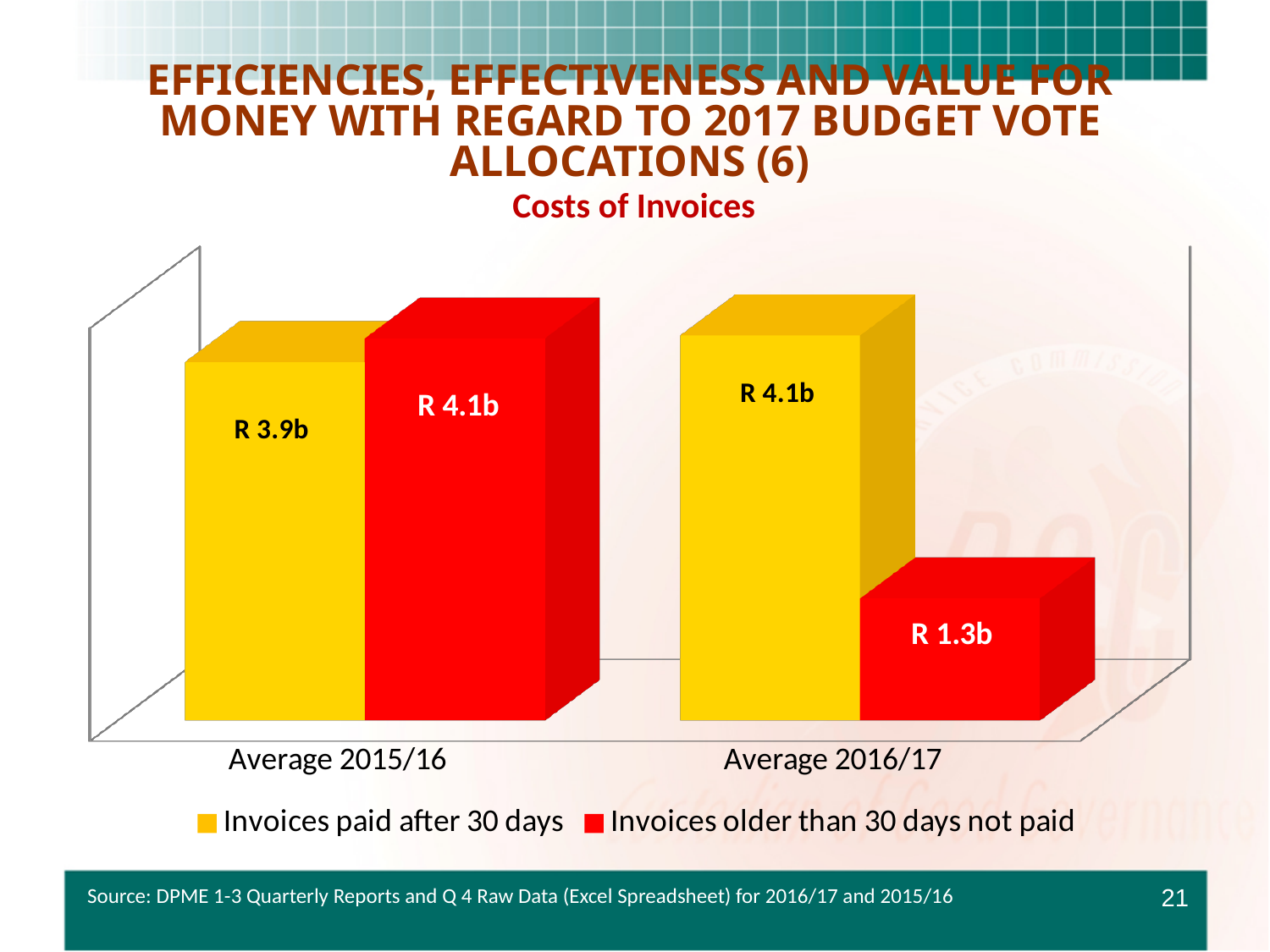
What is the value of 'Invoices older than 30 days not paid' for Average 2016/17? R 1.3b How many categories are shown on the x axis? 2 Which category has the lower value for 'Invoices older than 30 days not paid'? Average 2016/17 What is the value of 'Invoices paid after 30 days' for Average 2015/16? R 3.9b What is the value of 'Invoices older than 30 days not paid' for Average 2015/16? R 4.1b Does the value for 'Invoices older than 30 days not paid' rise or fall from Average 2015/16 to Average 2016/17? fall Which category has the higher value for 'Invoices older than 30 days not paid'? Average 2015/16 How many series does the legend list? 2 Which colour represents 'Invoices older than 30 days not paid' in the chart? red What is the value of 'Invoices paid after 30 days' for Average 2016/17? R 4.1b What is the difference between 'Invoices paid after 30 days' and 'Invoices older than 30 days not paid' for Average 2016/17? R 2.8b What type of chart is shown under the title 'Costs of Invoices'? bar chart